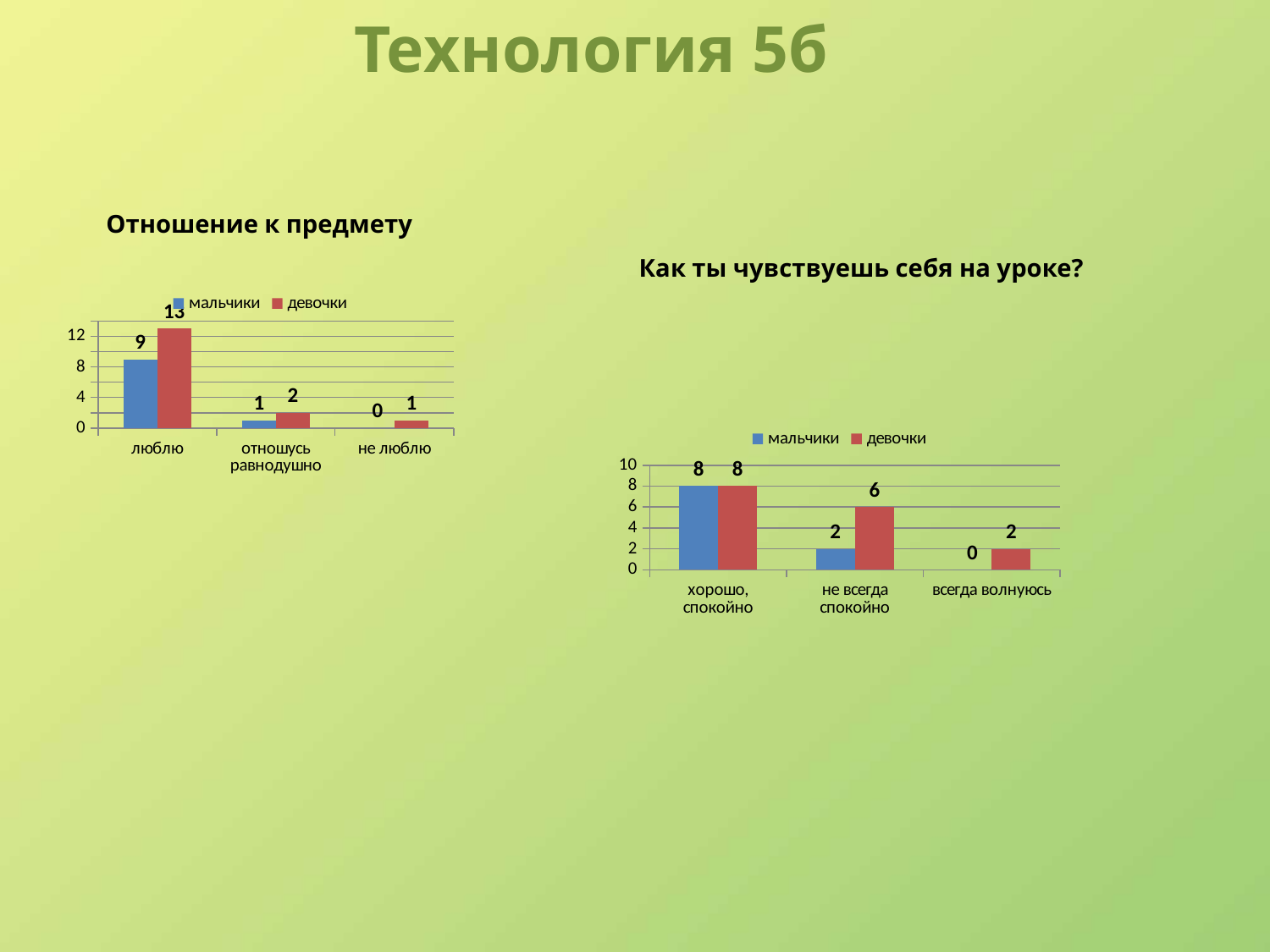
What kind of chart is the 'Отношение к предмету' chart? bar chart In the 'Отношение к предмету' chart, what is the value for девочки in the 'люблю' category? 13 How many series does the legend of the 'Как ты чувствуешь себя на уроке?' chart list? 2 In the 'Отношение к предмету' chart, what is the value for мальчики in the 'отношусь равнодушно' category? 1 In the 'Как ты чувствуешь себя на уроке?' chart, which category has the lowest value for девочки? всегда волнуюсь In the 'Отношение к предмету' chart, which category has the highest value for мальчики? люблю In the 'Как ты чувствуешь себя на уроке?' chart, what is the difference between девочки and мальчики in the 'не всегда спокойно' category? 4 In the 'Отношение к предмету' chart, what is the difference between девочки and мальчики in the 'люблю' category? 4 In the 'Как ты чувствуешь себя на уроке?' chart, what is the value for девочки in the 'не всегда спокойно' category? 6 In the 'Как ты чувствуешь себя на уроке?' chart, which is larger in the 'не всегда спокойно' category: мальчики or девочки? девочки In the 'Отношение к предмету' chart, how many categories are shown on the x axis? 3 In the 'Как ты чувствуешь себя на уроке?' chart, what is the value for мальчики in the 'всегда волнуюсь' category? 0